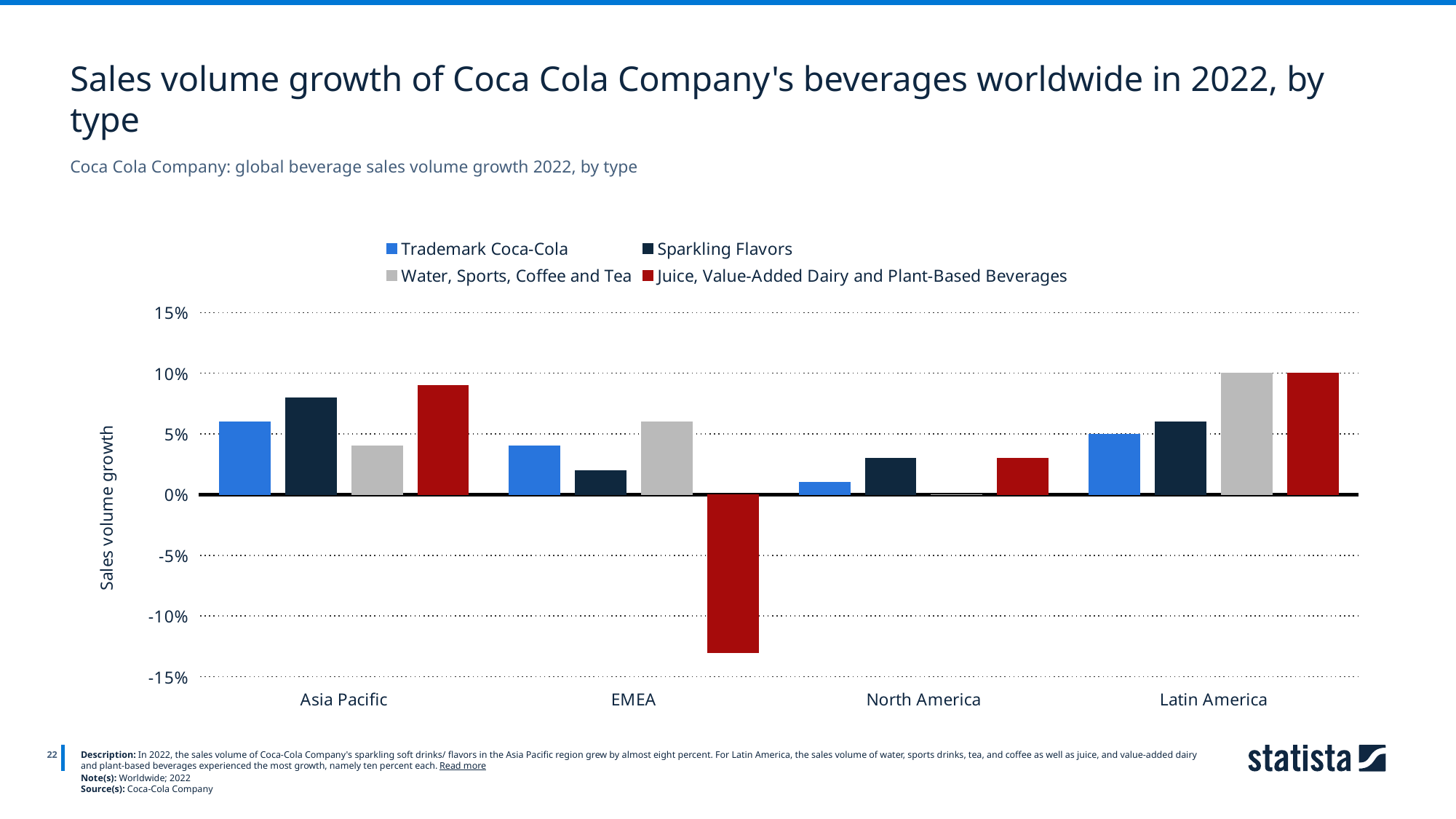
Is the value for Juice, Value-Added Dairy and Plant-Based Beverages in EMEA greater or less than -10%? less Which colour represents Sparkling Flavors in the legend? dark navy blue How many regions are shown on the x axis? 4 Which region has the lowest value for Juice, Value-Added Dairy and Plant-Based Beverages? EMEA What is the sales volume growth for Juice, Value-Added Dairy and Plant-Based Beverages in Latin America? 10% How many series does the legend list? 4 Is the value for Trademark Coca-Cola in North America greater or less than 5%? less What is the sales volume growth for Water, Sports, Coffee and Tea in Latin America? 10% Which region has the highest value for Water, Sports, Coffee and Tea? Latin America Which is larger in Asia Pacific: Trademark Coca-Cola or Water, Sports, Coffee and Tea? Trademark Coca-Cola Is the value for Sparkling Flavors in Asia Pacific greater or less than 5%? greater What kind of chart is shown on the slide? bar chart